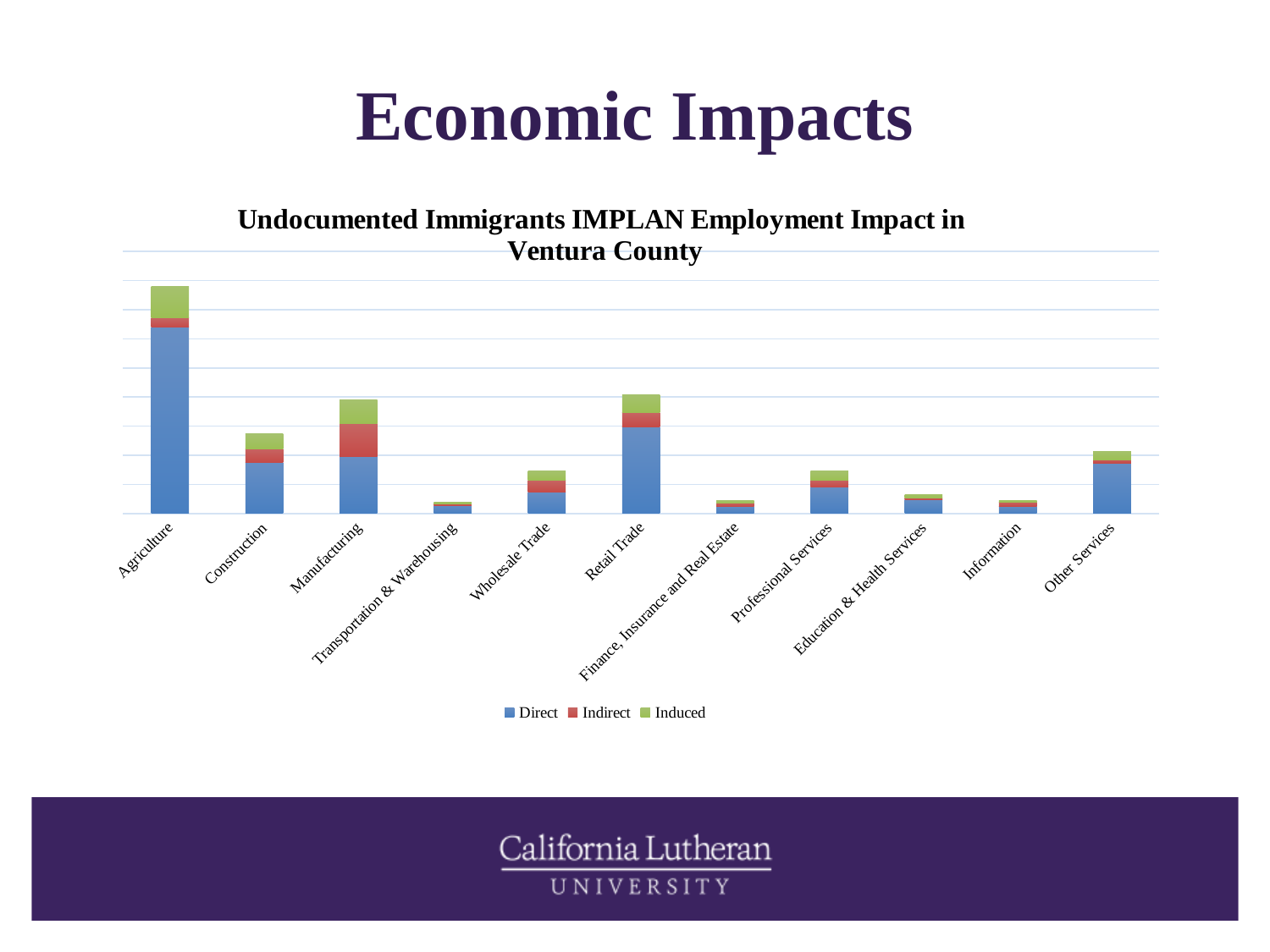
What are the three series named in the legend? Direct, Indirect, Induced How many series does the legend list? 3 Which industry has the second highest total employment impact? Retail Trade Which has a larger total employment impact, Other Services or Professional Services? Other Services Which has a larger Indirect employment impact, Manufacturing or Construction? Manufacturing Which industry has the largest Direct employment impact? Agriculture What is the title of the chart? Undocumented Immigrants IMPLAN Employment Impact in Ventura County Which has a larger total employment impact, Construction or Wholesale Trade? Construction What kind of chart is shown on the slide? Stacked bar chart How many industry categories are shown on the x axis? 11 Which industry has the highest total employment impact? Agriculture